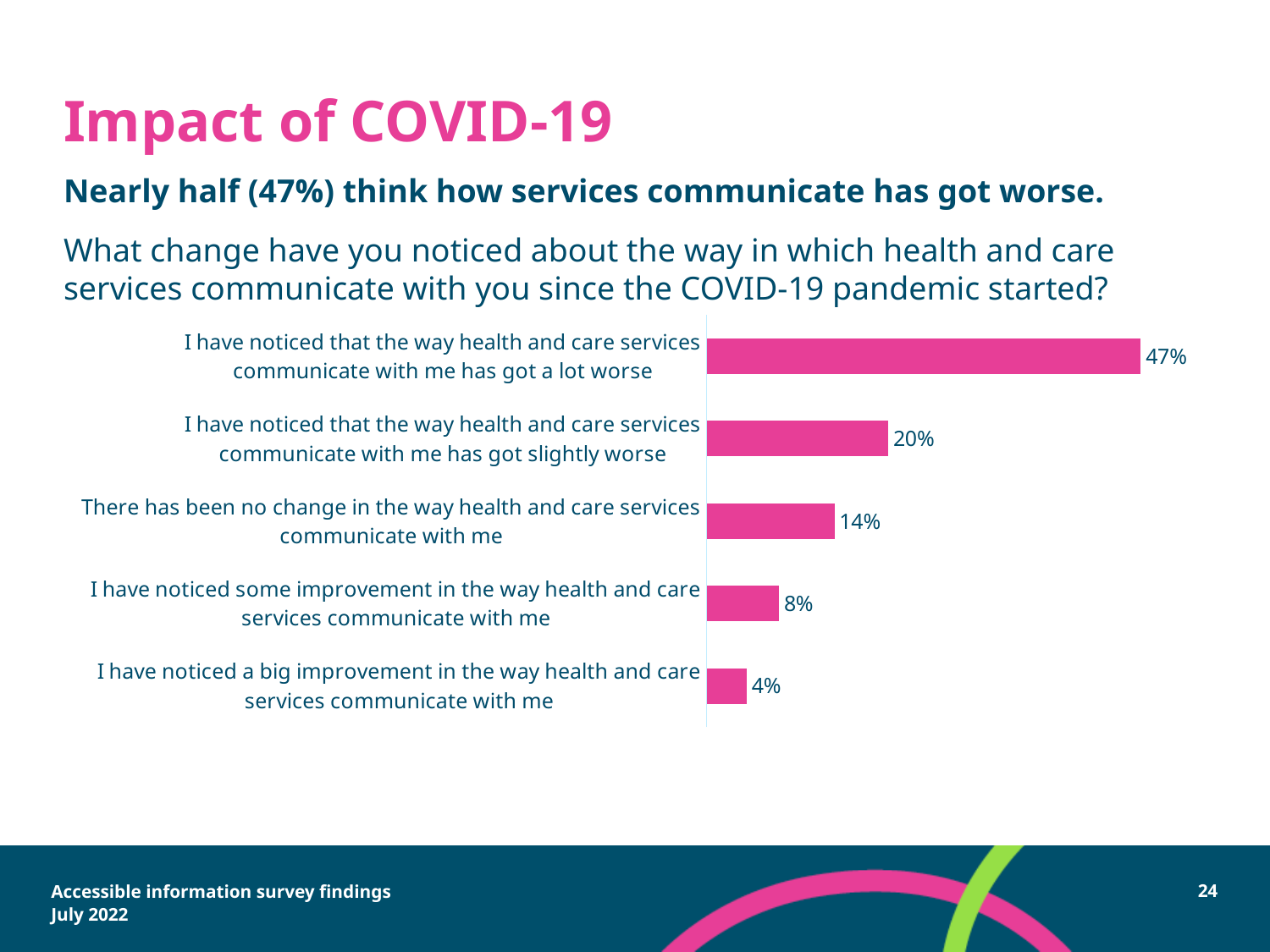
What colour are the bars in the chart? Pink What percentage of respondents noticed a big improvement in the way health and care services communicate with them? 4% What percentage of respondents said there has been no change in the way health and care services communicate with them? 14% What is the difference in percentage points between 'got a lot worse' and 'got slightly worse'? 27 Which response option has the highest percentage? I have noticed that the way health and care services communicate with me has got a lot worse What percentage of respondents said communication has got slightly worse? 20% What type of chart is shown on the slide? Bar chart Which is larger: the percentage for 'no change' or the percentage for 'some improvement'? There has been no change in the way health and care services communicate with me Which response option has the lowest percentage? I have noticed a big improvement in the way health and care services communicate with me What percentage of respondents said the way health and care services communicate with them has got a lot worse? 47% How many response options are shown in the chart? 5 What percentage of respondents noticed some improvement in the way health and care services communicate with them? 8%